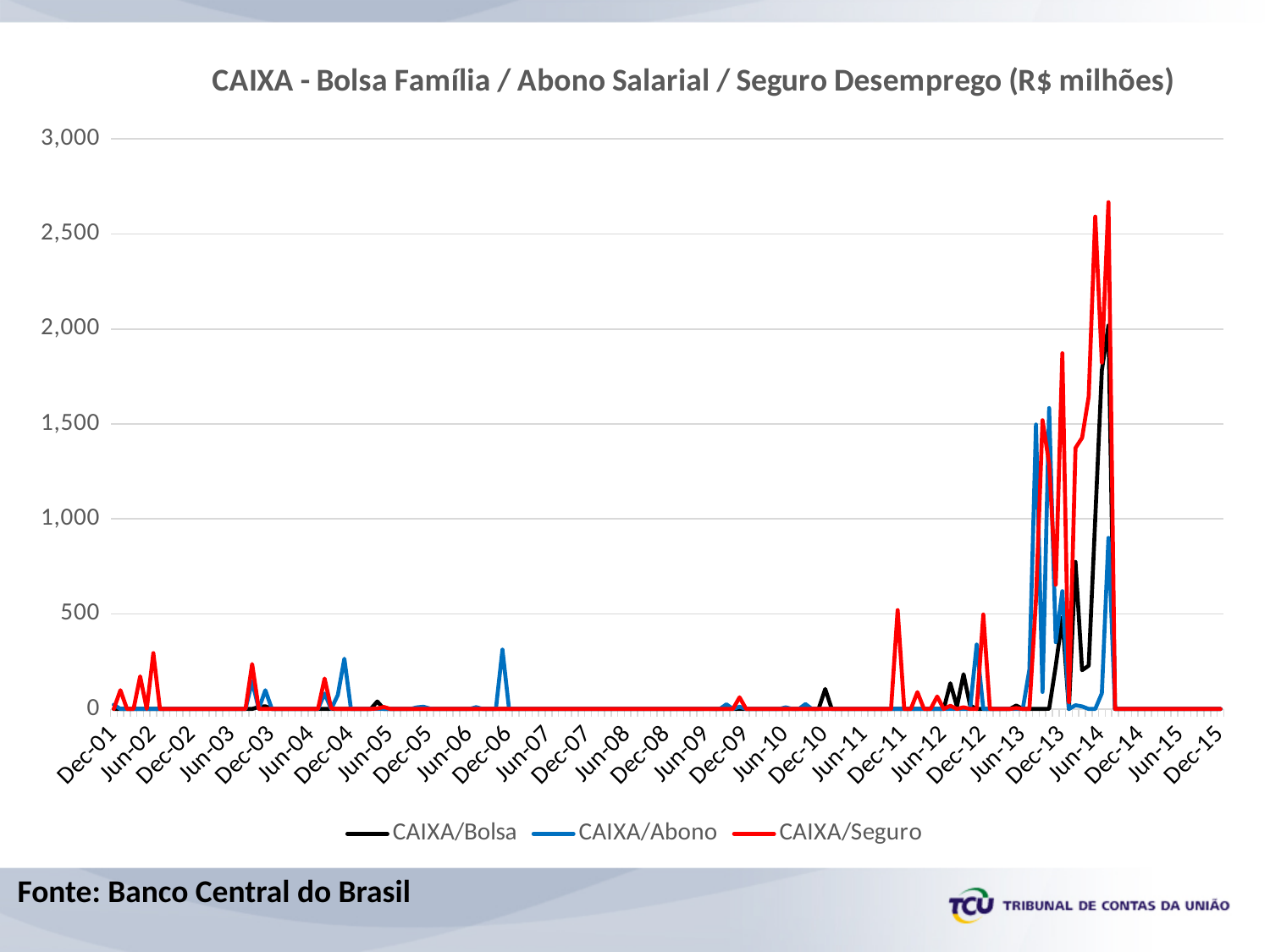
Do the values for all three series rise or fall after their peaks around Jun-14? fall What kind of chart is shown on the slide? Line chart Is the value for CAIXA/Seguro at Dec-15 greater or less than 500? less Which colour is used for the CAIXA/Seguro series? Red Which series has the higher peak, CAIXA/Bolsa or CAIXA/Abono? CAIXA/Bolsa Which series reaches the highest value on the chart? CAIXA/Seguro Is the highest value reached by CAIXA/Seguro greater or less than 2,500? greater Is the highest value reached by CAIXA/Abono greater or less than 1,000? greater What is the title of the chart? CAIXA - Bolsa Família / Abono Salarial / Seguro Desemprego (R$ milhões) How many series does the legend list? 3 What is the highest value shown on the y axis? 3,000